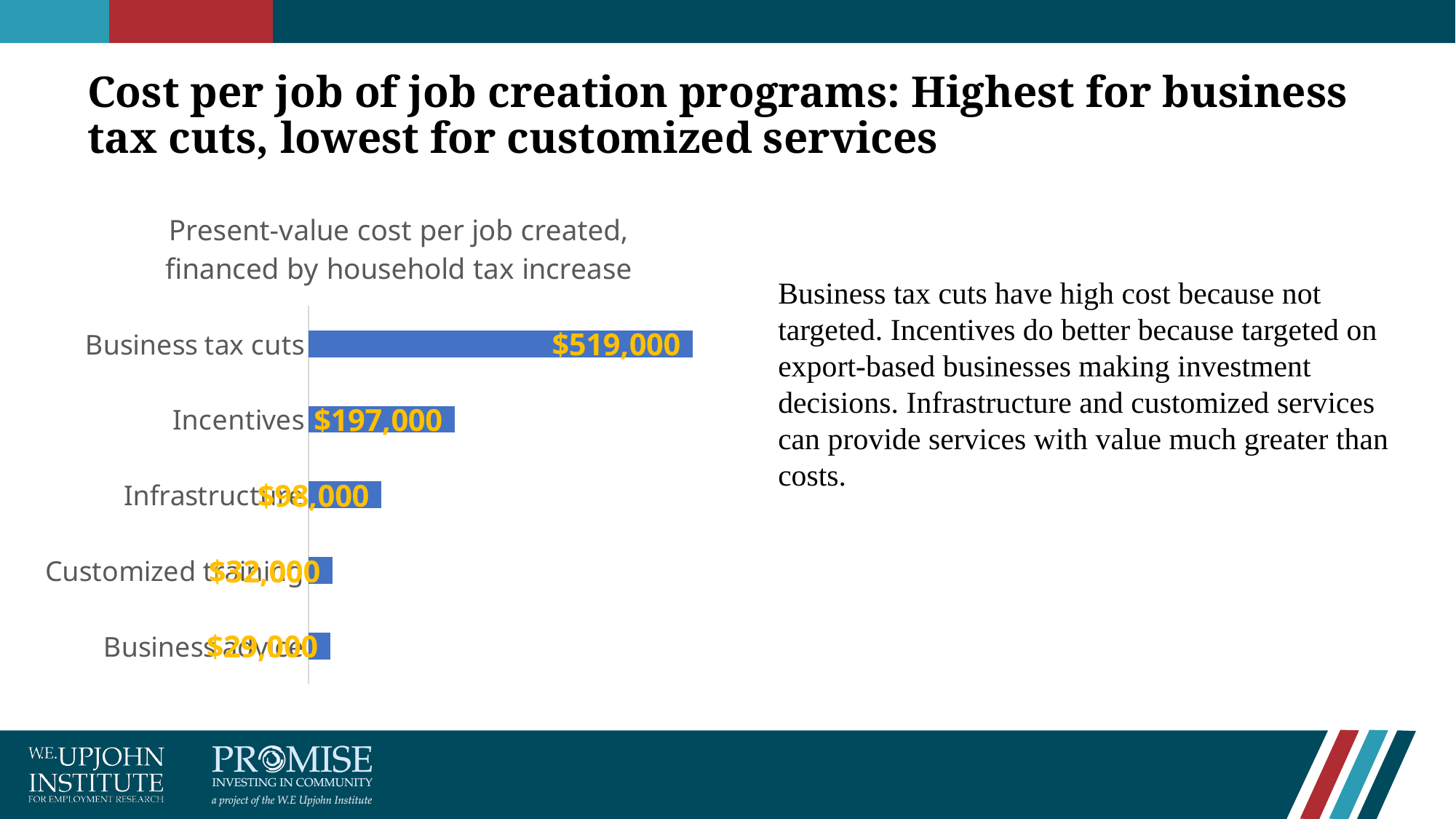
What is the difference in cost per job between Business tax cuts and Infrastructure? $421,000 Which has a higher cost per job created, Incentives or Infrastructure? Incentives What type of chart is used on this slide? Bar chart What is the title of the chart? Present-value cost per job created, financed by household tax increase What is the difference in cost per job between Incentives and Infrastructure? $99,000 What is the cost per job created for Incentives? $197,000 What is the cost per job created for Infrastructure? $98,000 What is the cost per job created for Customized training? $32,000 Which program has the highest cost per job created? Business tax cuts How much higher is the cost per job for Business tax cuts than for Incentives? $322,000 How many programs are shown in the chart? 5 What is the present-value cost per job created for Business tax cuts? $519,000